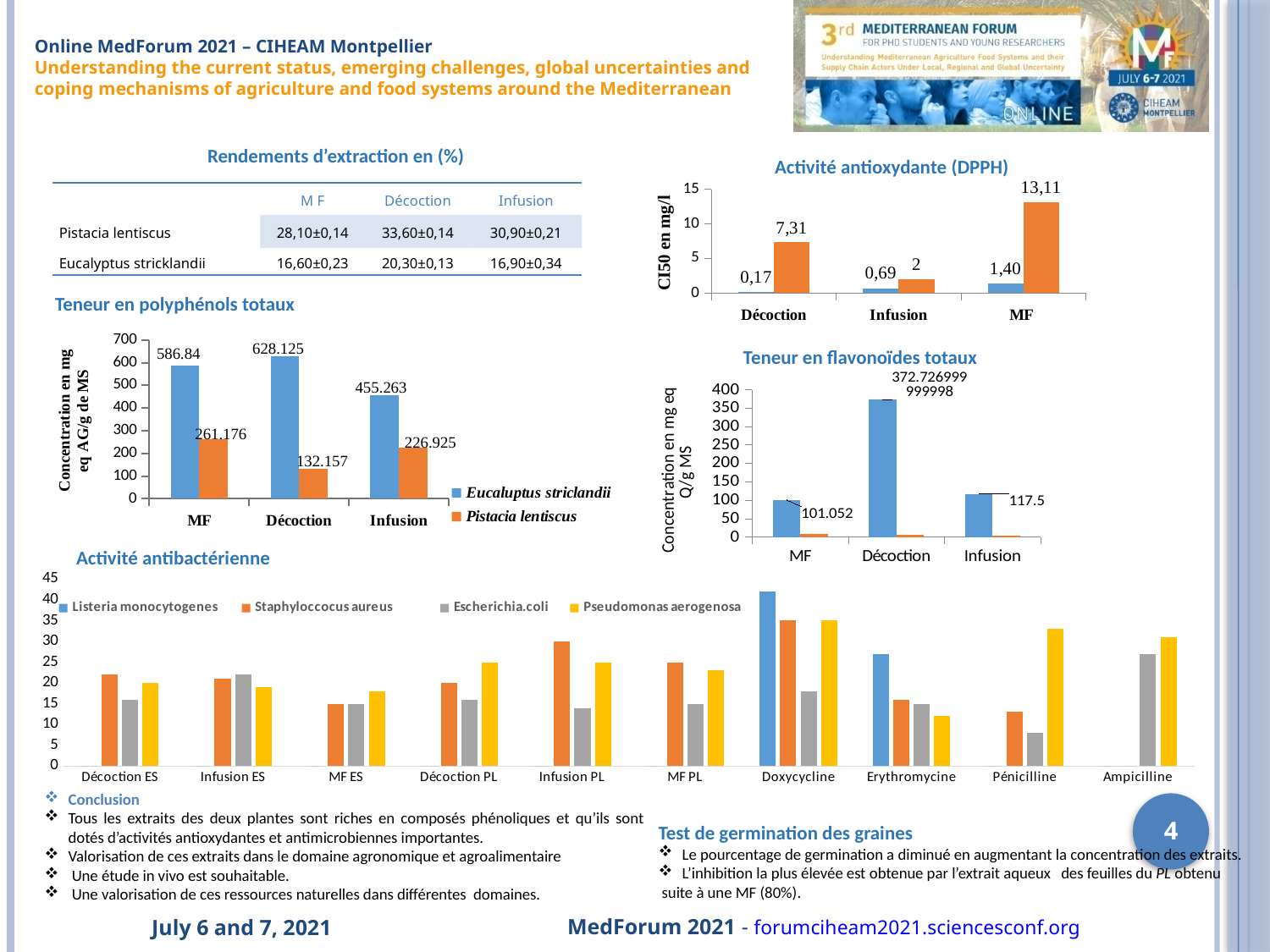
In the 'Teneur en polyphénols totaux' chart, what is the value for Eucaluptus striclandii at Décoction? 628.125 In the 'Activité antioxydante (DPPH)' chart, what is the lowest labelled value? 0,17 In the 'Teneur en polyphénols totaux' chart, which category has the lowest value for Pistacia lentiscus? Décoction In the 'Teneur en flavonoïdes totaux' chart, which category has the highest blue bar? Décoction In the 'Teneur en flavonoïdes totaux' chart, what is the labelled value for Infusion? 117.5 In the 'Activité antioxydante (DPPH)' chart, what is the value of the orange bar for Infusion? 2 In the 'Activité antibactérienne' chart, is the value for Listeria monocytogenes at Doxycycline greater or less than 40? greater How many series does the legend of the 'Teneur en polyphénols totaux' chart list? 2 In the 'Teneur en polyphénols totaux' chart, what is the value for Pistacia lentiscus at Infusion? 226.925 In the 'Activité antioxydante (DPPH)' chart, what is the highest labelled value? 13,11 In the 'Teneur en polyphénols totaux' chart, what is the difference between the Eucaluptus striclandii and Pistacia lentiscus values at MF? 325.664 How many series does the legend of the 'Activité antibactérienne' chart list? 4